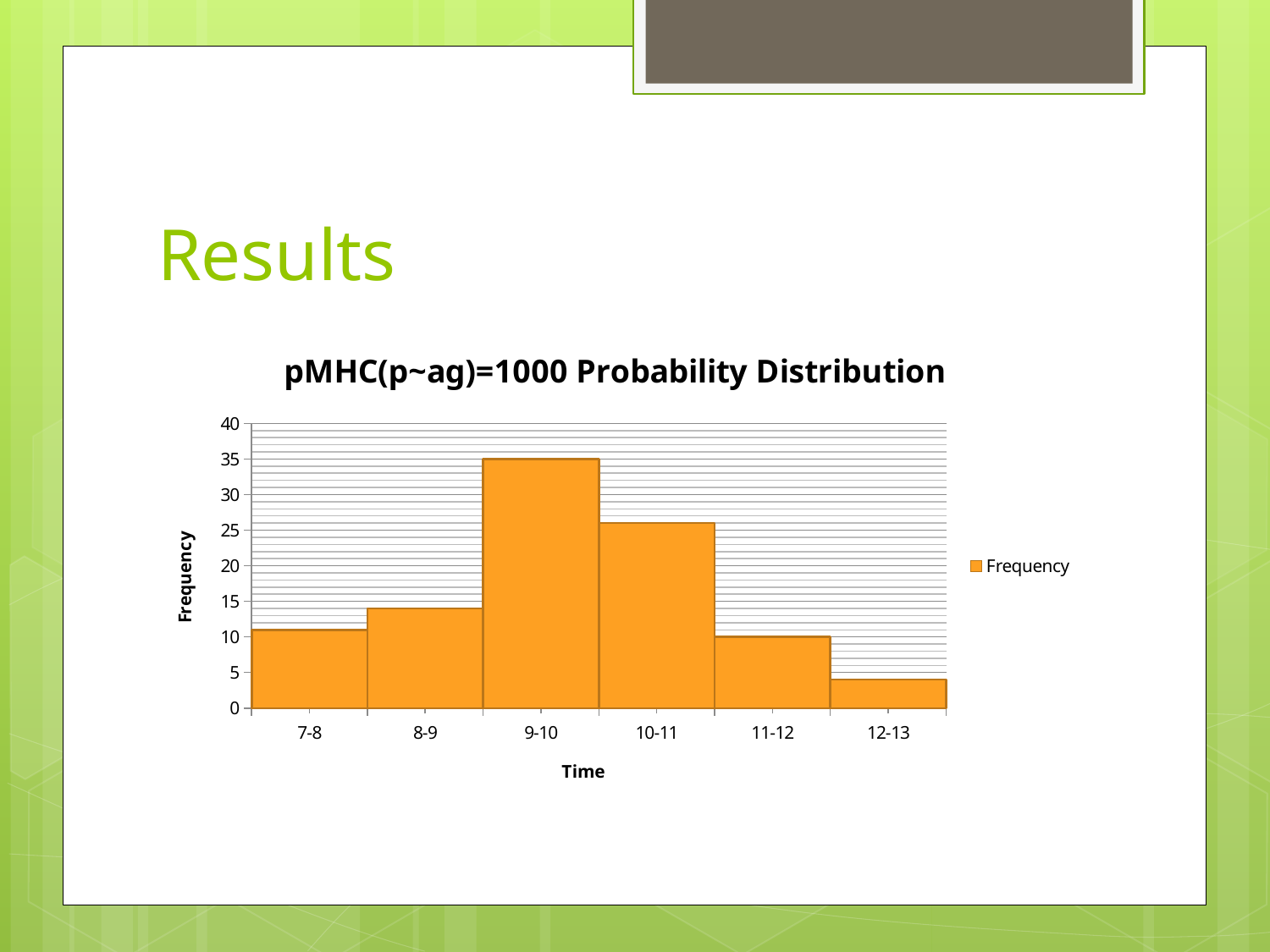
How many time categories are shown on the x axis? 6 How many series does the legend list? 1 Is the frequency for the 7-8 bin greater or less than 15? less What is the title of the chart? pMHC(p~ag)=1000 Probability Distribution What is the difference in frequency between the 9-10 bin and the 11-12 bin? 25 Which has a higher frequency, the 10-11 bin or the 8-9 bin? 10-11 From the 9-10 bin to the 12-13 bin, do the frequencies rise or fall? fall Which time bin has the highest frequency? 9-10 What is the frequency for the 11-12 time bin? 10 What is the frequency for the 9-10 time bin? 35 Which time bin has the lowest frequency? 12-13 What type of chart is shown on the slide? bar chart